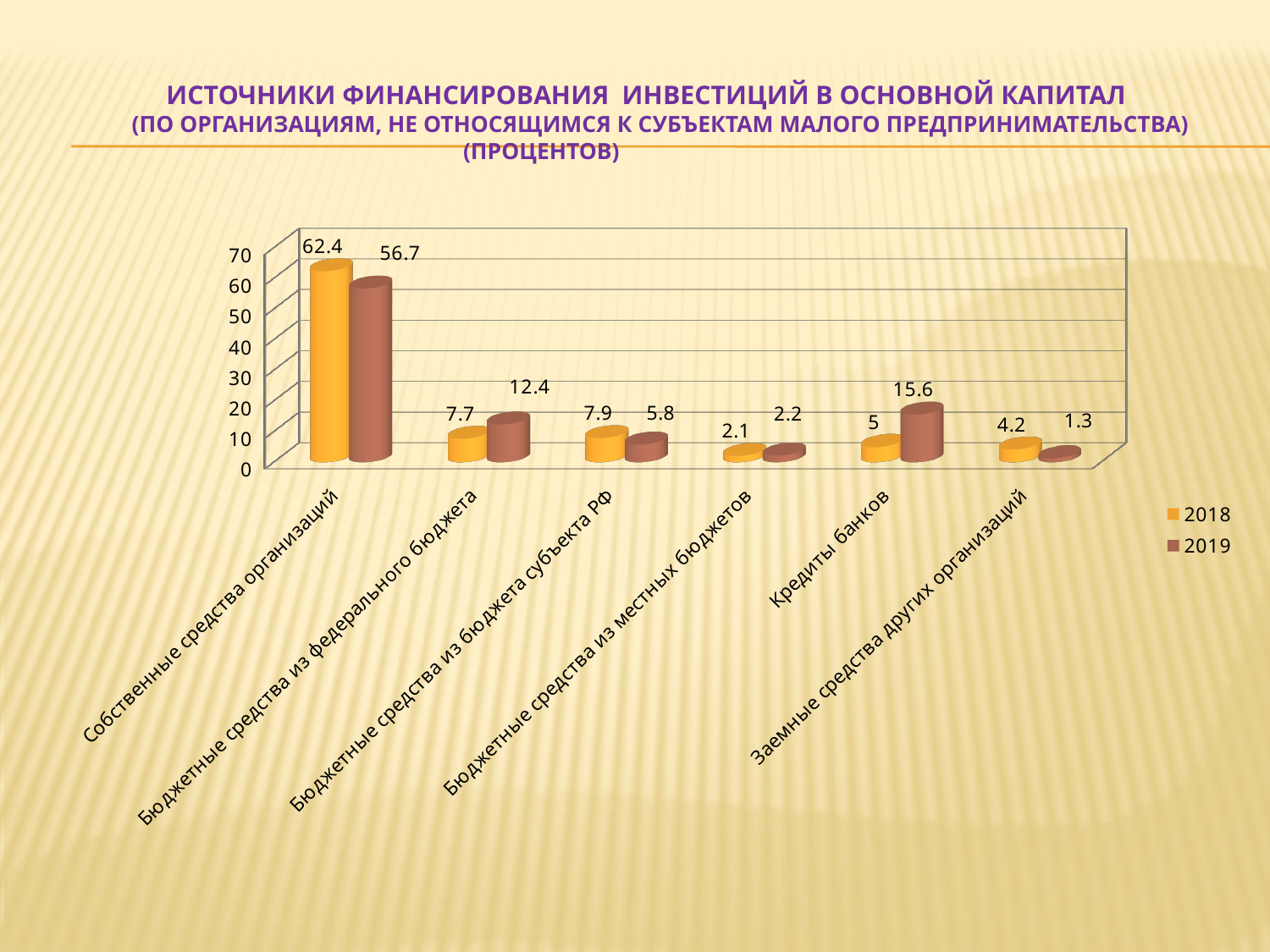
How many series does the legend list? 2 Which is larger for Кредиты банков, the 2018 value or the 2019 value? 2019 Which category has the lowest 2019 value? Заемные средства других организаций What is the 2018 value for Заемные средства других организаций? 4.2 What is the 2019 value for Бюджетные средства из федерального бюджета? 12.4 How many categories are shown on the x axis? 6 What is the 2018 value for Собственные средства организаций? 62.4 Is the 2019 value for Собственные средства организаций greater or less than 50? greater What is the difference between the 2018 and 2019 values for Собственные средства организаций? 5.7 What kind of chart is shown on the slide? bar chart Which category has the highest 2019 value? Собственные средства организаций What is the 2019 value for Кредиты банков? 15.6